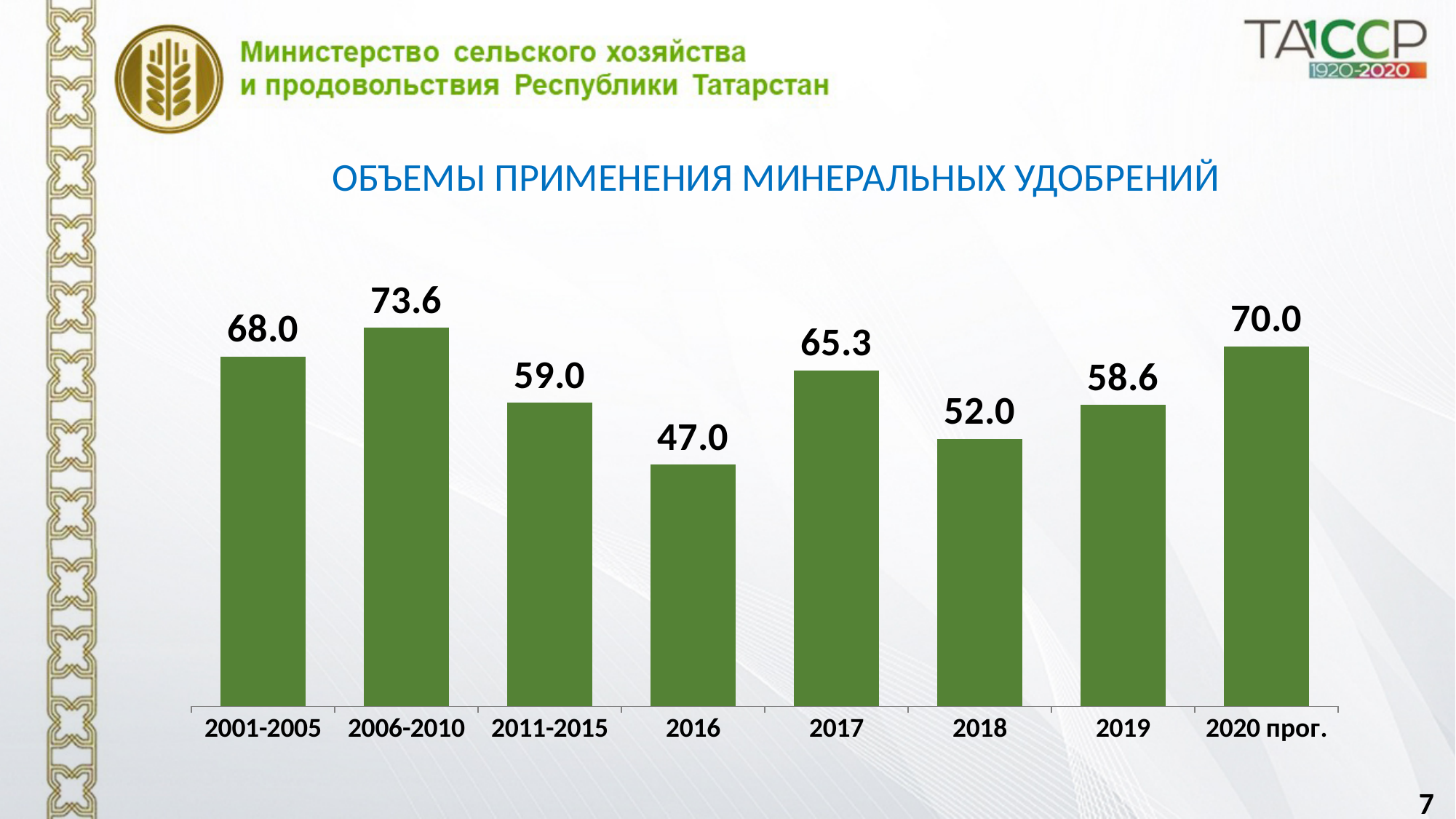
What is the value for 2001-2005? 68.0 What is the difference between the values for 2017 and 2018? 13.3 What is the value for 2020 прог.? 70.0 Which is larger, the value for 2011-2015 or the value for 2019? 2011-2015 What is the difference between the values for 2006-2010 and 2016? 26.6 How many categories are shown on the x axis? 8 Which category has the highest value? 2006-2010 What is the title of the chart? ОБЪЕМЫ ПРИМЕНЕНИЯ МИНЕРАЛЬНЫХ УДОБРЕНИЙ What kind of chart is shown on the slide? bar chart What is the value for 2016? 47.0 Which category has the lowest value? 2016 What is the value for 2019? 58.6